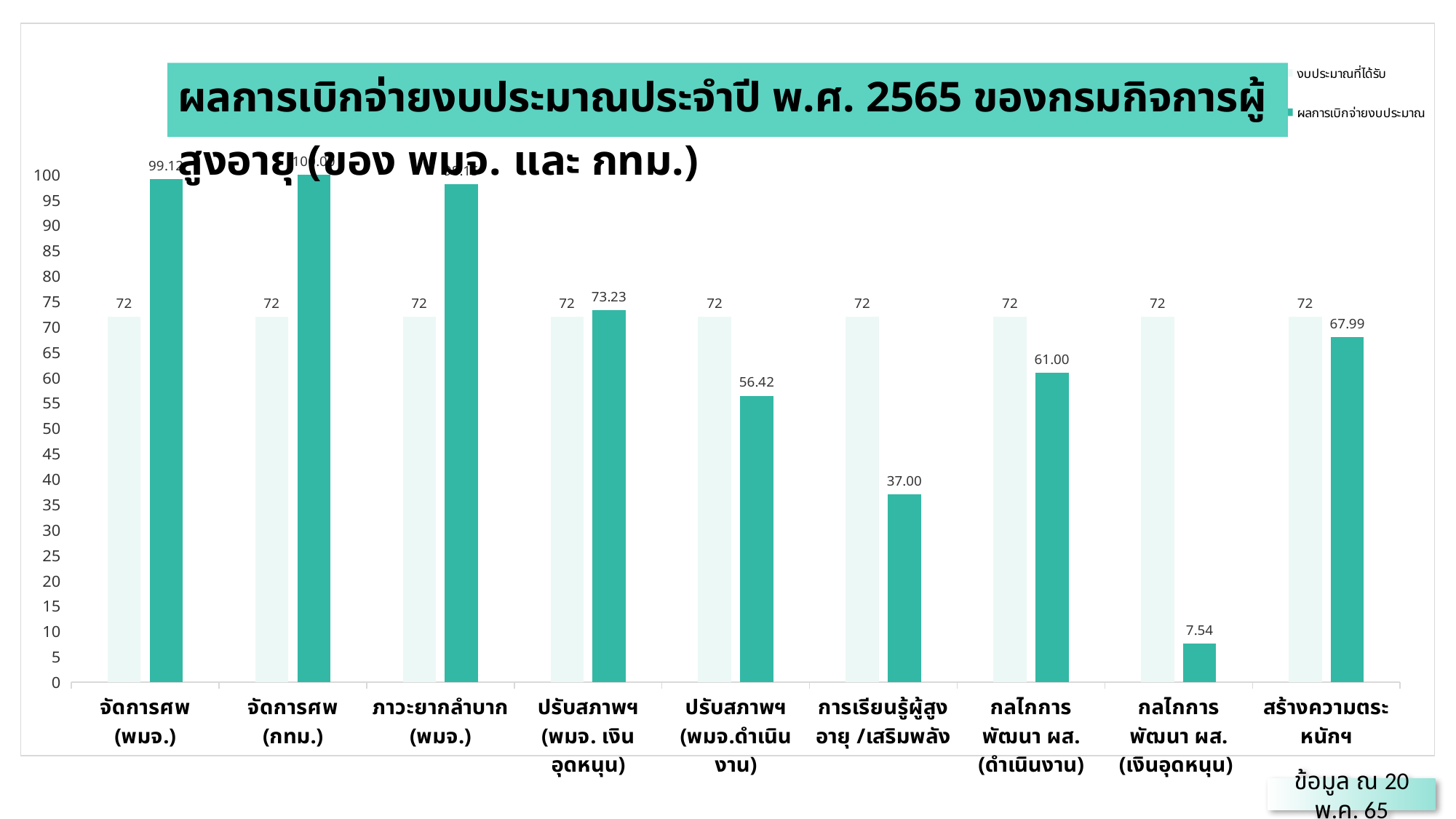
What is the ผลการเบิกจ่ายงบประมาณ value for ปรับสภาพฯ (พมจ. เงินอุดหนุน)? 73.23 What type of chart is shown on the slide? bar chart What is the ผลการเบิกจ่ายงบประมาณ value for กลไกการพัฒนา ผส. (เงินอุดหนุน)? 7.54 Is the ผลการเบิกจ่ายงบประมาณ value for จัดการศพ (กทม.) greater or less than 90? greater What is the ผลการเบิกจ่ายงบประมาณ value for จัดการศพ (พมจ.)? 99.12 How many series does the legend list? 2 Which category has the lowest ผลการเบิกจ่ายงบประมาณ value? กลไกการพัฒนา ผส. (เงินอุดหนุน) Which is larger: the ผลการเบิกจ่ายงบประมาณ value for ปรับสภาพฯ (พมจ.ดำเนินงาน) or for สร้างความตระหนักฯ? สร้างความตระหนักฯ What colour are the ผลการเบิกจ่ายงบประมาณ bars? teal What is the difference between the ผลการเบิกจ่ายงบประมาณ values for กลไกการพัฒนา ผส. (ดำเนินงาน) and การเรียนรู้ผู้สูงอายุ /เสริมพลัง? 24.00 What is the งบประมาณที่ได้รับ value for สร้างความตระหนักฯ? 72 How many categories are shown on the x axis? 9